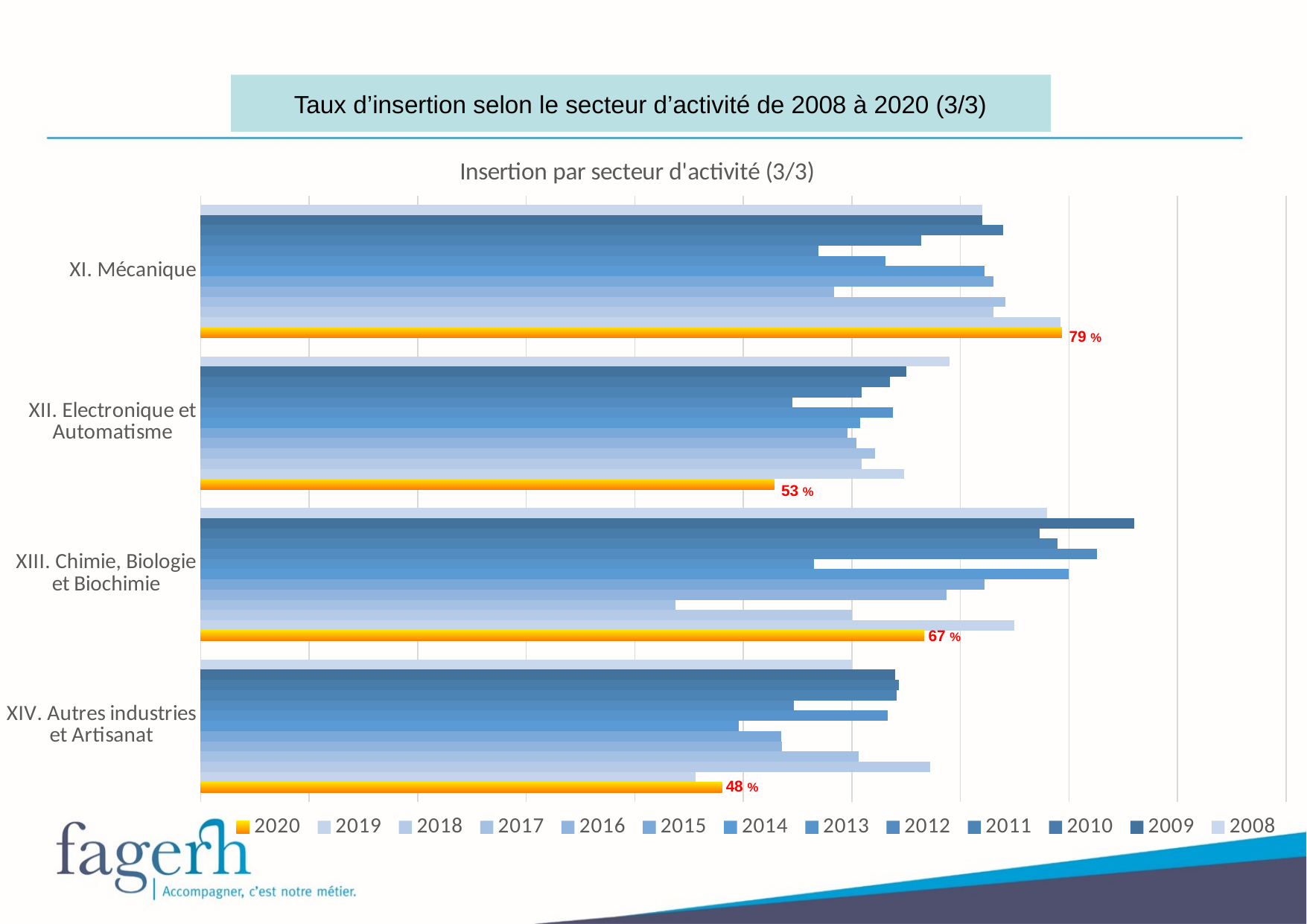
What is the 2020 value for XIV. Autres industries et Artisanat? 48 % How many series does the legend list? 13 What is the 2020 value for XIII. Chimie, Biologie et Biochimie? 67 % What is the 2020 value for XI. Mécanique? 79 % How many sectors are shown on the chart? 4 Which sector has the lowest 2020 value? XIV. Autres industries et Artisanat What is the title of the chart? Insertion par secteur d'activité (3/3) What kind of chart is shown on the slide? Bar chart What is the 2020 value for XII. Electronique et Automatisme? 53 % Which sector has the highest 2020 value? XI. Mécanique What is the difference between the 2020 values for XI. Mécanique and XIV. Autres industries et Artisanat? 31 % Which has the larger 2020 value, XII. Electronique et Automatisme or XIII. Chimie, Biologie et Biochimie? XIII. Chimie, Biologie et Biochimie